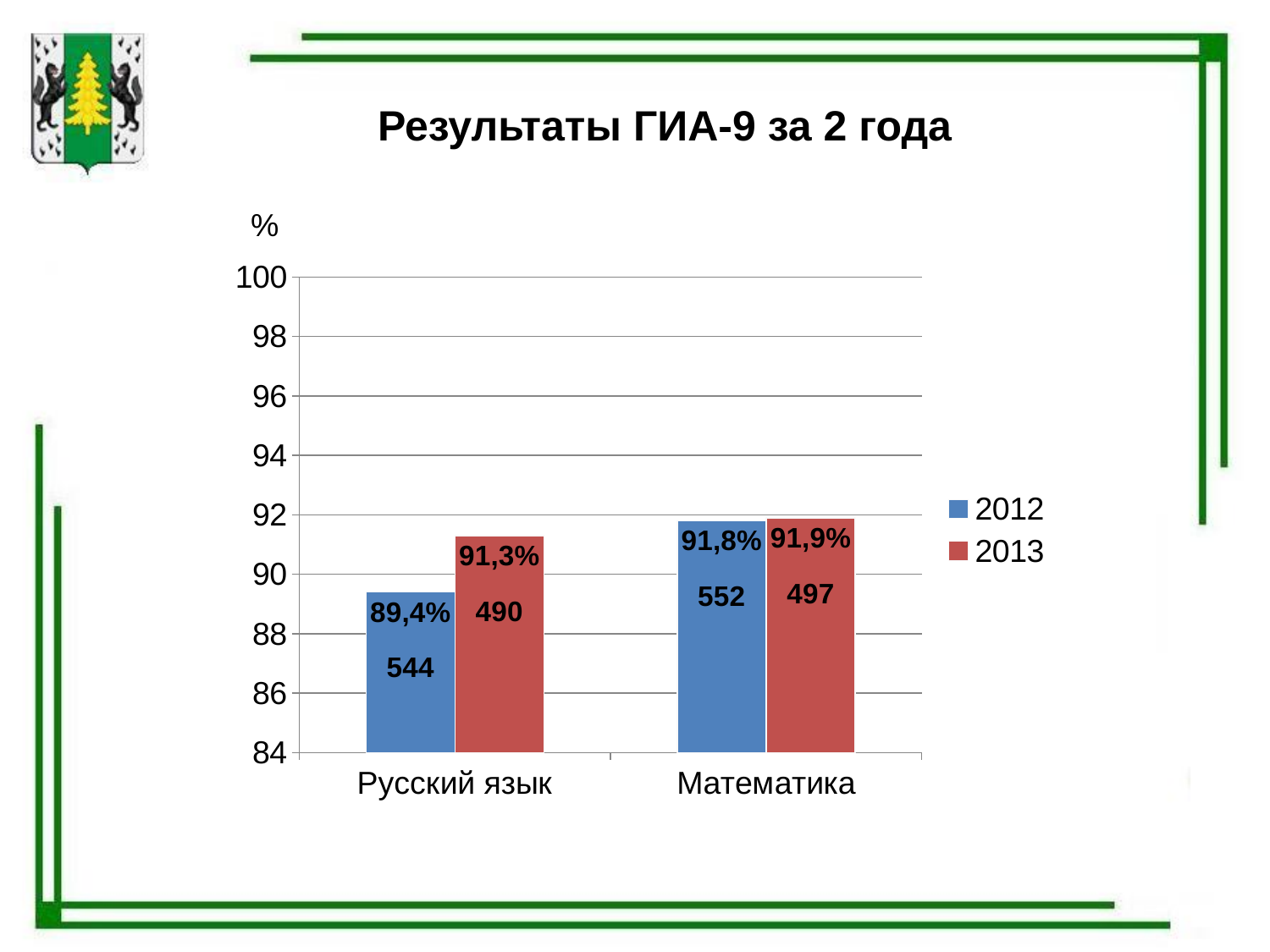
How many series does the legend list? 2 Is the value for Русский язык in 2012 greater or less than 90? less What is the percentage value for Математика in 2013? 91,9% What is the percentage value for Русский язык in 2012? 89,4% What is the percentage value for Русский язык in 2013? 91,3% By how many percentage points does the 2013 value for Русский язык exceed the 2012 value? 1,9 Which is larger for Русский язык: the 2012 value or the 2013 value? 2013 What type of chart is shown on the slide? Bar chart Which bar has the lowest percentage value? Русский язык, 2012 What is the title of the chart? Результаты ГИА-9 за 2 года How many categories are shown on the x axis? 2 What number is printed on the 2012 bar for Математика? 552